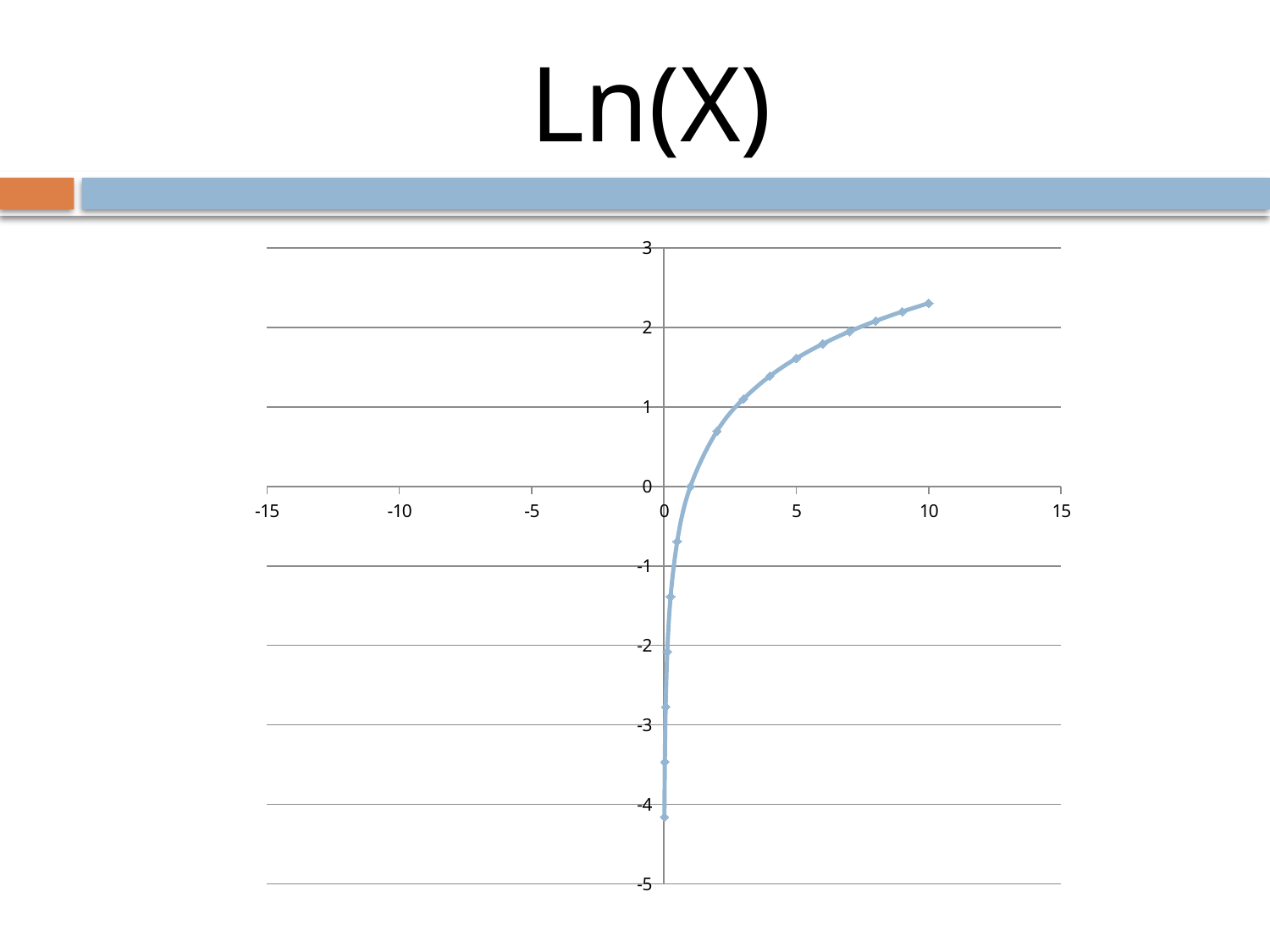
At which x value does the curve reach its highest plotted point? 10 Which plotted point is higher: the one at x = 10 or the one at x = 5? x = 10 Is the plotted value at x = 2 greater or less than 1? less Is the plotted value at x = 5 greater or less than 2? less Do the plotted values rise or fall as x increases? rise What is the plotted value at x = 1? 0 Is this chart a bar chart or a line chart? line chart How many data series are plotted on the chart? 1 Is the plotted value at x = 10 greater or less than 2? greater What is the title of the slide/chart? Ln(X) What is the lowest value shown on the vertical axis? -5